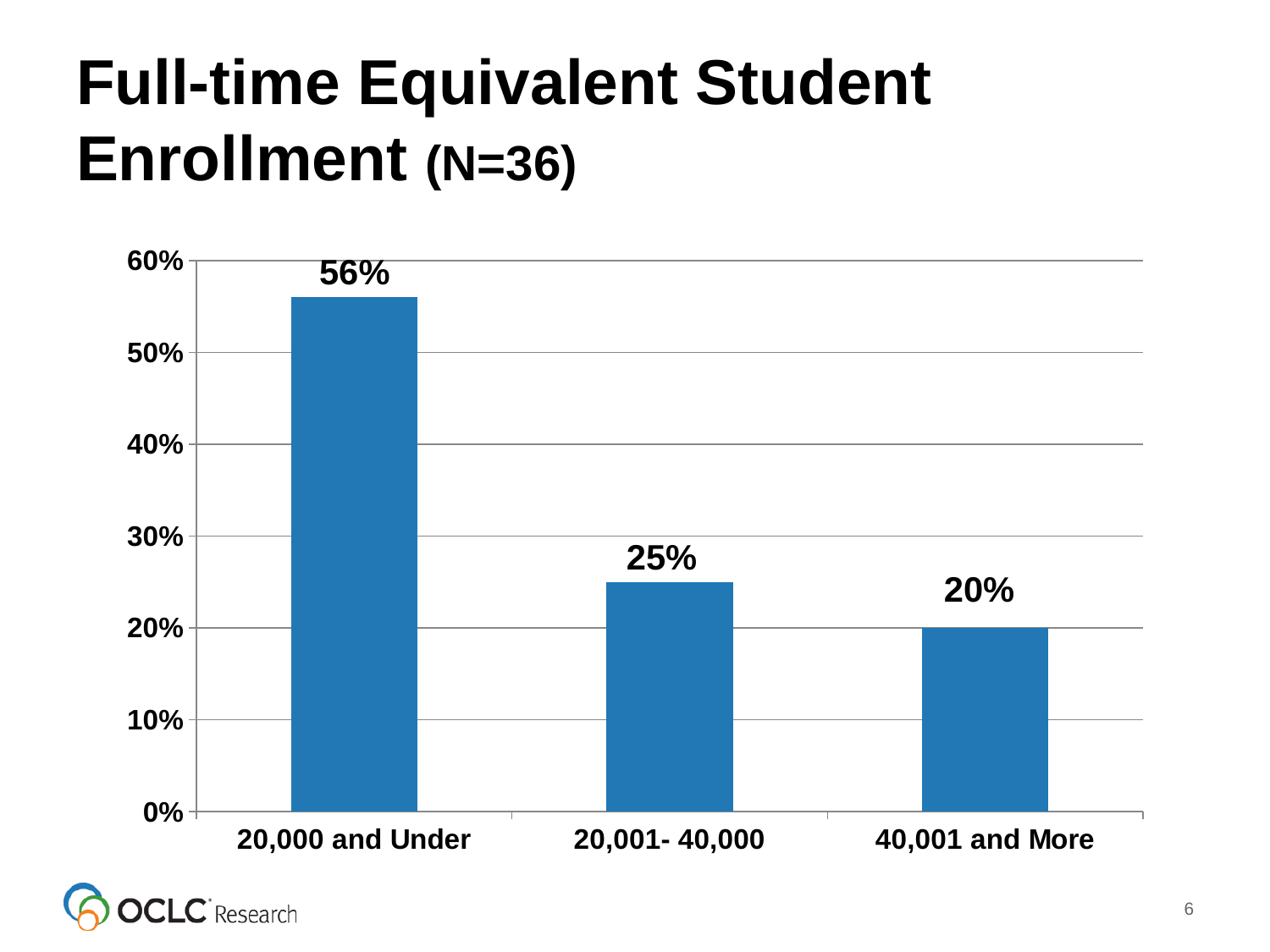
Which is larger: the value for 20,001- 40,000 or the value for 40,001 and More? 20,001- 40,000 What percentage of institutions have a full-time equivalent student enrollment of 20,000 and Under? 56% Which enrollment category has the lowest percentage? 40,001 and More What type of chart is shown on the slide? Bar chart What is the difference between the 20,001- 40,000 category and the 40,001 and More category? 5 percentage points Which enrollment category has the highest percentage? 20,000 and Under How many enrollment categories are shown in the chart? 3 What is the value shown for the 20,001- 40,000 enrollment category? 25% What is the difference in percentage points between the 20,000 and Under category and the 20,001- 40,000 category? 31 percentage points Is the value for 20,000 and Under greater or less than 50%? greater Do the values rise or fall moving from left to right across the enrollment categories? Fall What is the value shown for the 40,001 and More enrollment category? 20%